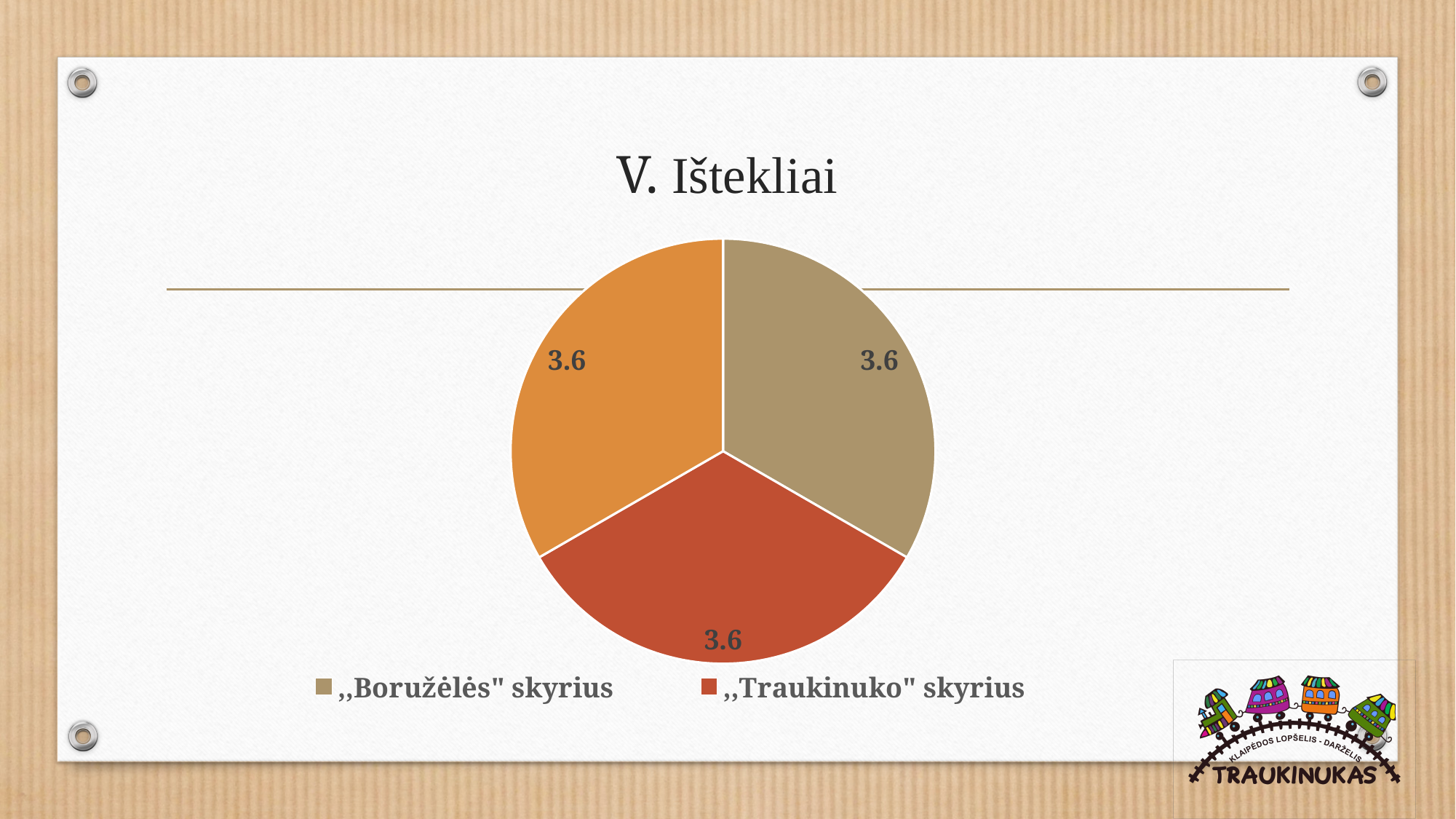
What is the title of the chart? V. Ištekliai What colour is the ,,Traukinuko" skyrius slice? red Do all three slices of the pie chart have the same value? yes What value is shown for the ,,Traukinuko" skyrius slice? 3.6 How many entries does the legend list? 2 How many slices does the pie chart have? 3 What share of the pie does the ,,Traukinuko" skyrius slice represent? one third Is the value for ,,Boružėlės" skyrius larger than, smaller than, or equal to the value for ,,Traukinuko" skyrius? equal What is the total of all the slice values in the pie chart? 10.8 What is the difference between the values for ,,Boružėlės" skyrius and ,,Traukinuko" skyrius? 0 What value is shown for the ,,Boružėlės" skyrius slice? 3.6 What kind of chart is shown on the slide? pie chart